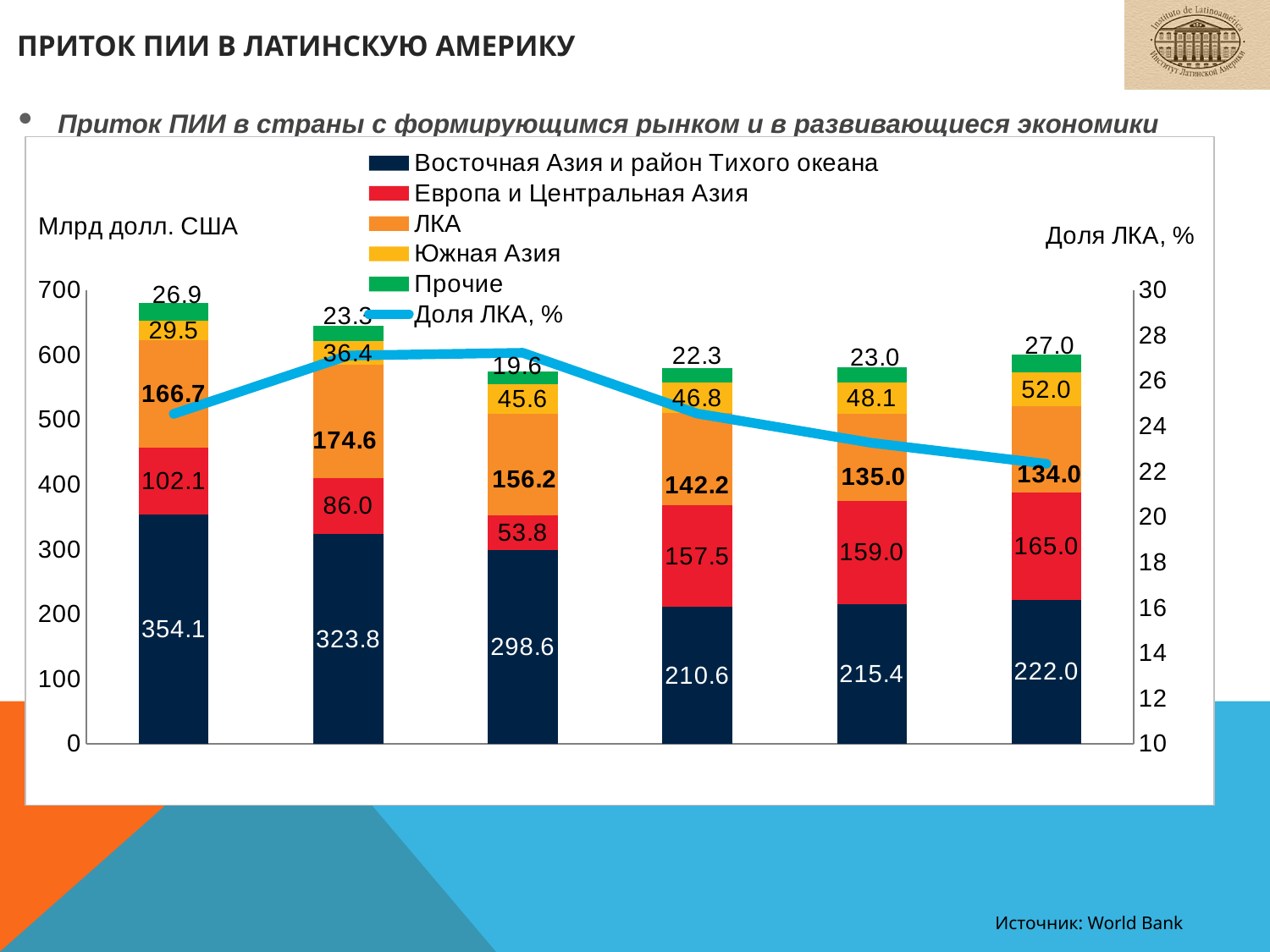
In which bar is the ЛКА segment the highest? The second bar (174.6) What is the difference between the Европа и Центральная Азия values in the sixth and third bars? 111.2 What is the value of the Восточная Азия и район Тихого океана segment in the last (rightmost) bar? 222.0 In which bar is the Восточная Азия и район Тихого океана segment the lowest? The fourth bar (210.6) How many series does the legend list? 6 Which is larger in the fifth bar: the Европа и Центральная Азия segment or the ЛКА segment? Европа и Центральная Азия (159.0) What is the value of the ЛКА segment in the first (leftmost) bar? 166.7 What is the value of the Южная Азия segment in the third bar? 45.6 Is the Доля ЛКА, % value at the last point greater or less than 24? less What is the total of the rightmost stacked bar? 600.0 How many stacked bars are plotted in the chart? 6 What type of chart is shown on the slide? Stacked bar chart with a line